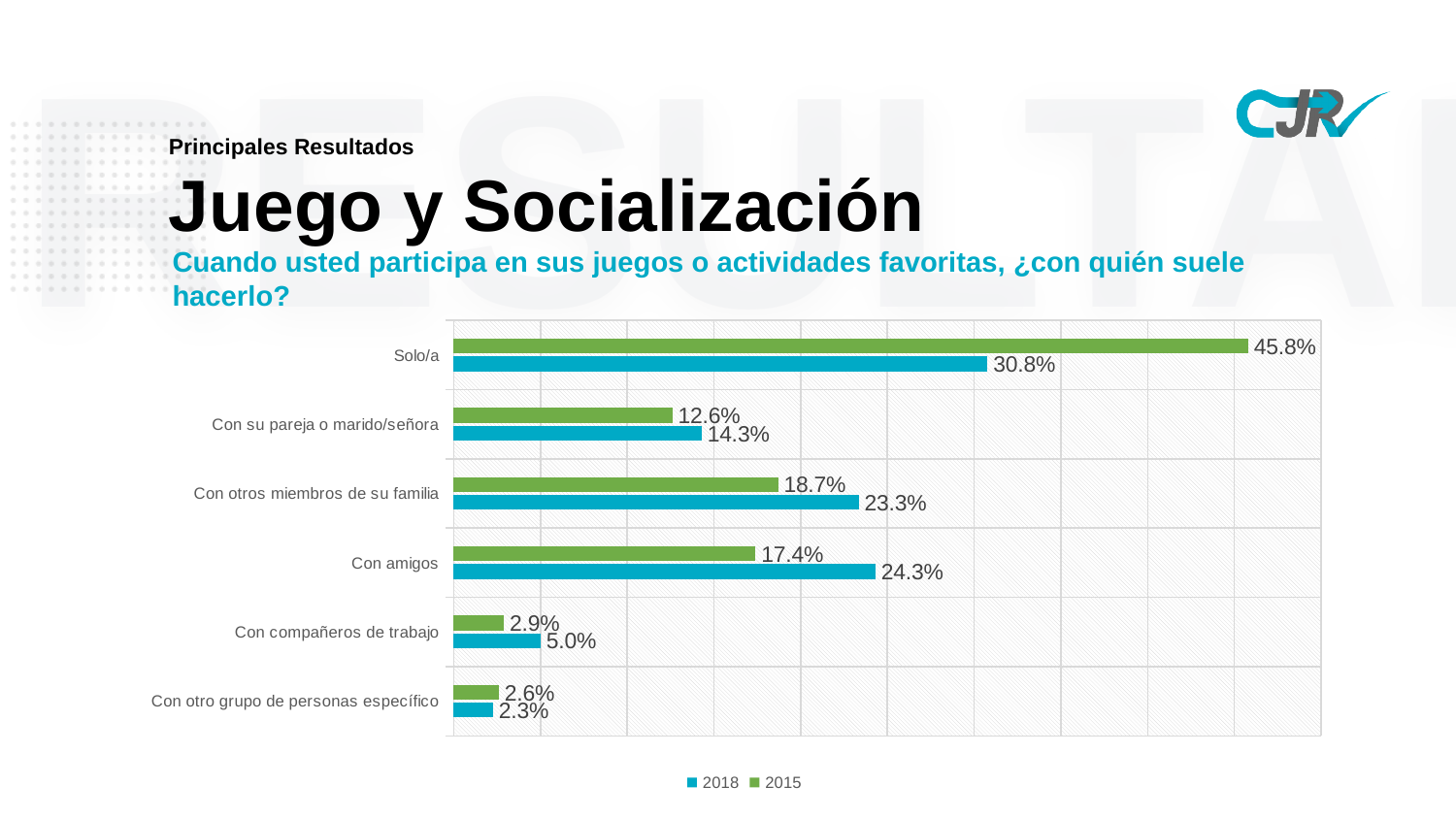
What is the difference between the 2015 and 2018 values for Solo/a? 15.0% How many series does the legend list? 2 What is the 2018 value for Con amigos? 24.3% What kind of chart is shown on the slide? bar chart Which colour represents the 2015 series in the legend? green What is the difference between the 2018 and 2015 values for Con amigos? 6.9% For Con otros miembros de su familia, which year has the larger value, 2015 or 2018? 2018 What is the 2015 value for Solo/a? 45.8% Which category has the lowest 2015 value? Con otro grupo de personas específico What is the 2018 value for Con compañeros de trabajo? 5.0% How many categories are shown on the chart? 6 Which category has the highest 2018 value? Solo/a